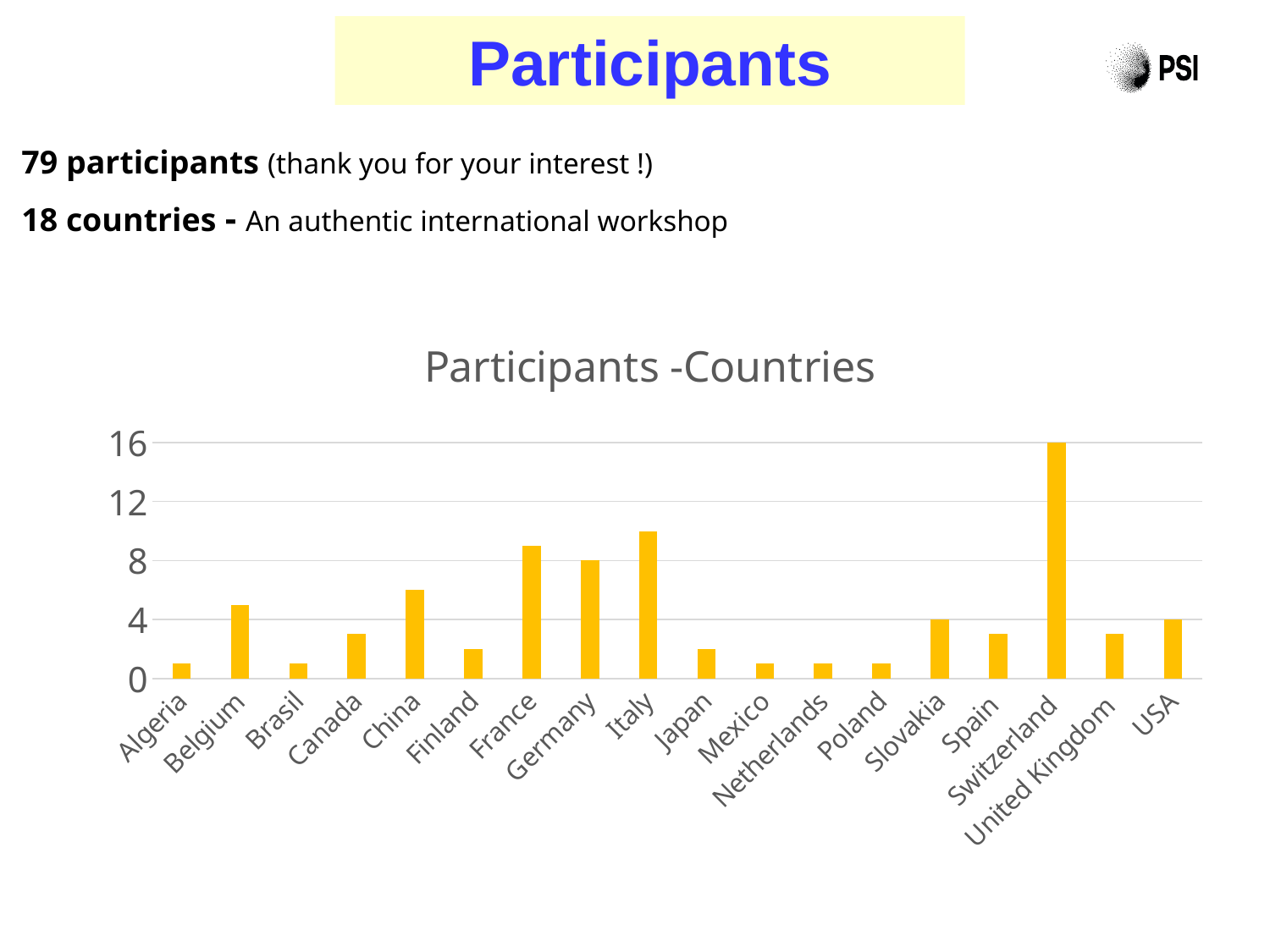
Which country has the highest number of participants? Switzerland Is the value for Finland greater or less than 4? less Which has more participants, China or Finland? China What is the title of the chart? Participants -Countries Is the value for France greater or less than 8? greater What type of chart is shown on the slide? bar chart What is the difference between the number of participants from Switzerland and from Germany? 8 How many participants are from Germany? 8 How many countries are shown on the x axis of the chart? 18 How many participants are from Switzerland? 16 Which has more participants, Belgium or Canada? Belgium How many participants are from Slovakia? 4